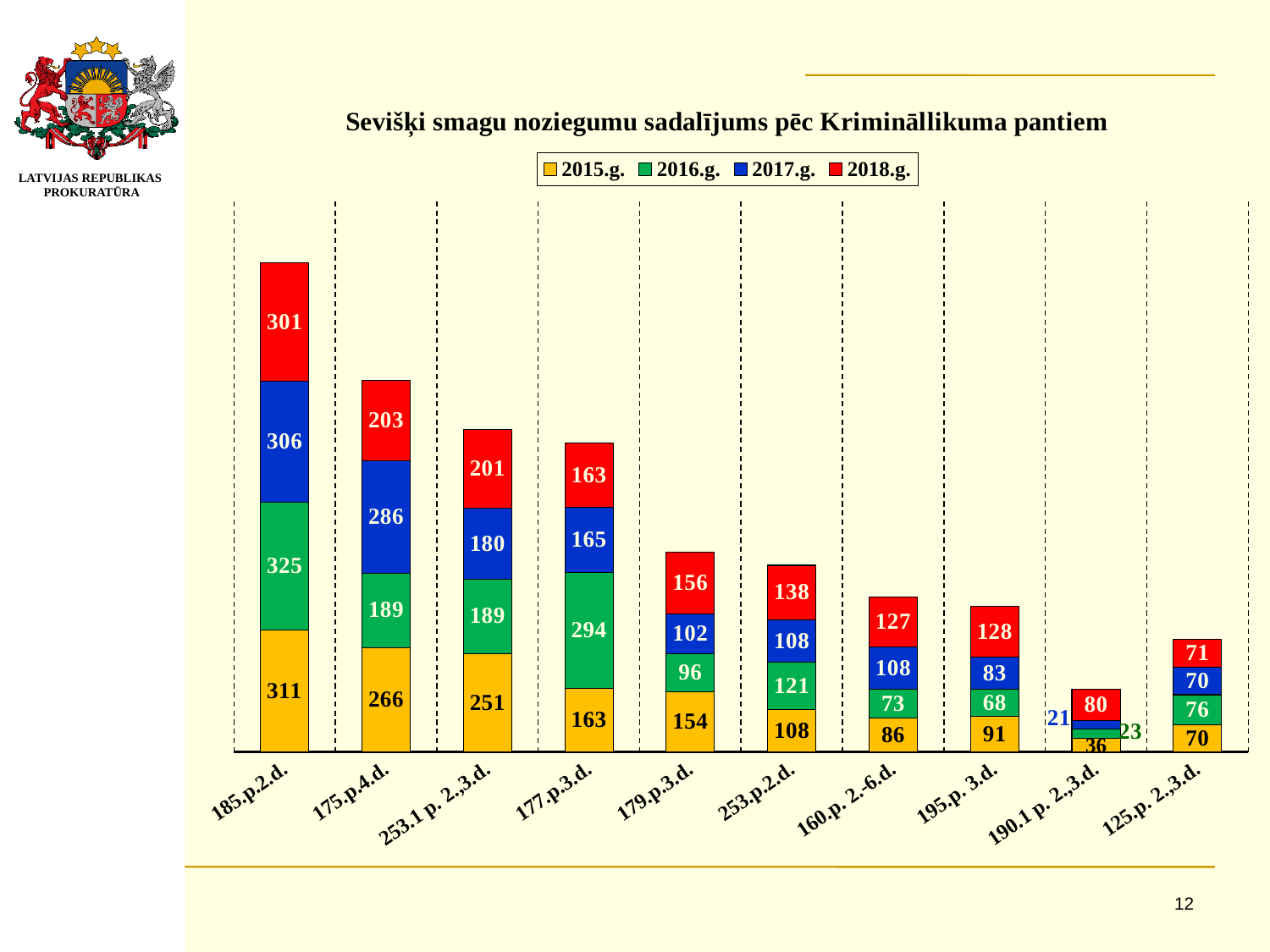
What type of chart is shown on the slide? stacked bar chart What is the 2016.g. value for 177.p.3.d.? 294 What is the 2018.g. value for 195.p. 3.d.? 128 Which is larger: the 2018.g. value for 253.p.2.d. or the 2018.g. value for 160.p. 2.-6.d.? 253.p.2.d. Which category has the lowest total stacked bar? 190.1 p. 2.,3.d. What is the title of the chart? Sevišķi smagu noziegumu sadalījums pēc Krimināllikuma pantiem How many series does the legend list? 4 What is the total of the stacked bar for 179.p.3.d.? 508 Which category has the highest total stacked bar? 185.p.2.d. How many categories (Criminal Law articles) are shown on the x axis? 10 What is the difference between the 2017.g. values for 175.p.4.d. and 253.1 p. 2.,3.d.? 106 What is the 2015.g. value for 185.p.2.d.? 311